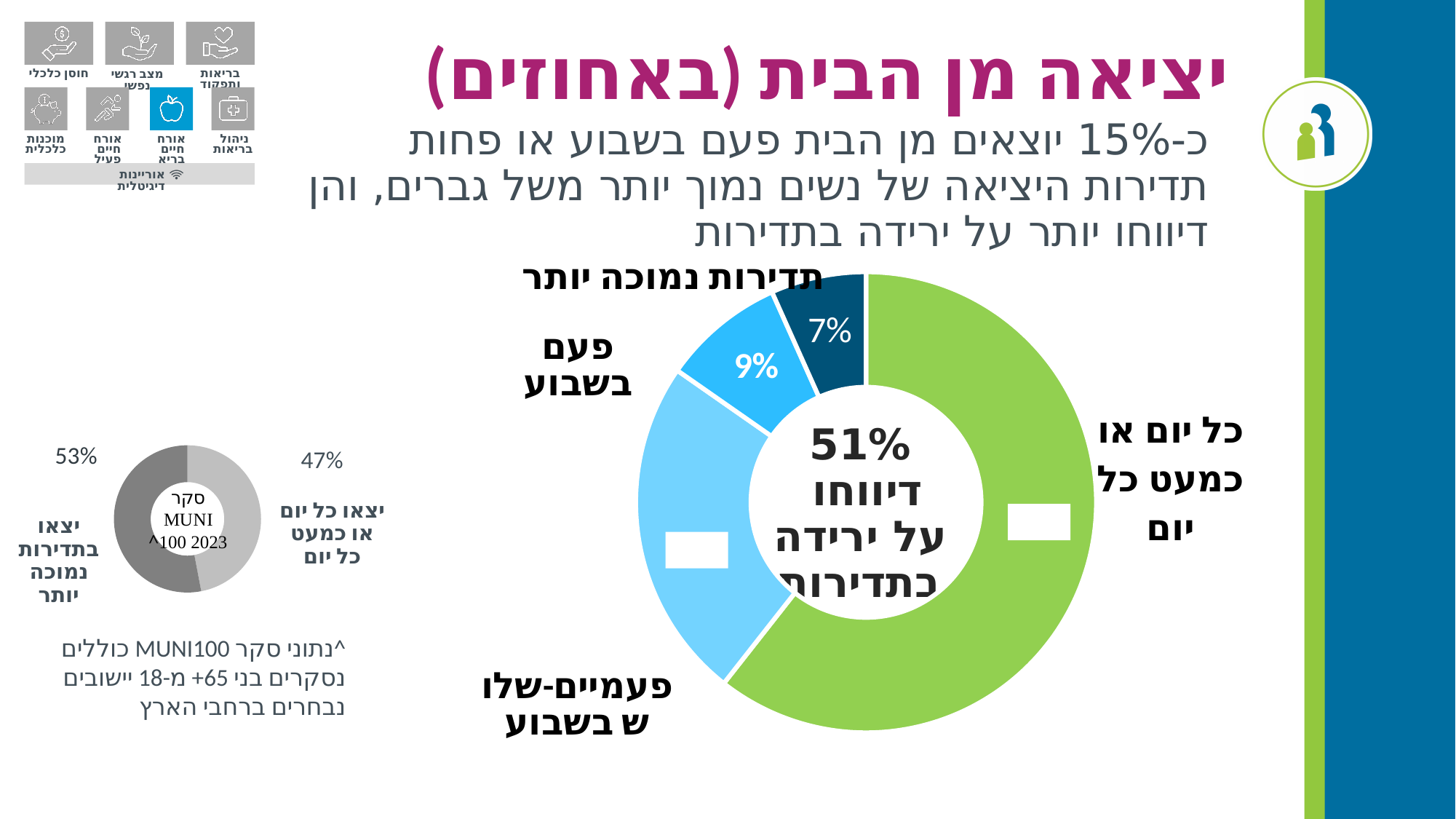
In the large donut chart, which labelled category has the smallest slice? תדירות נמוכה יותר How many categories does the large donut chart have? 4 In the small MUNI 100 2023 donut chart on the left, what percentage went out every day or almost every day ('יצאו כל יום או כמעט כל יום')? 47% In the small MUNI 100 2023 donut chart on the left, what is the difference in percentage points between the two slices? 6 percentage points What type of chart is the large chart in the centre of the slide? Donut (pie) chart In the large donut chart, what percentage is shown for the 'תדירות נמוכה יותר' (lower frequency) slice? 7% In the large donut chart, which is larger: the 'פעם בשבוע' slice or the 'תדירות נמוכה יותר' slice? פעם בשבוע In the large donut chart, what percentage is shown for the 'פעם בשבוע' (once a week) slice? 9% In the large donut chart, which category has the largest slice? כל יום או כמעט כל יום In the small MUNI 100 2023 donut chart on the left, what percentage went out at a lower frequency ('יצאו בתדירות נמוכה יותר')? 53% What percentage is written in the centre of the large donut chart? 51% In the large donut chart, what is the difference in percentage points between the 'פעם בשבוע' slice (9%) and the 'תדירות נמוכה יותר' slice (7%)? 2 percentage points